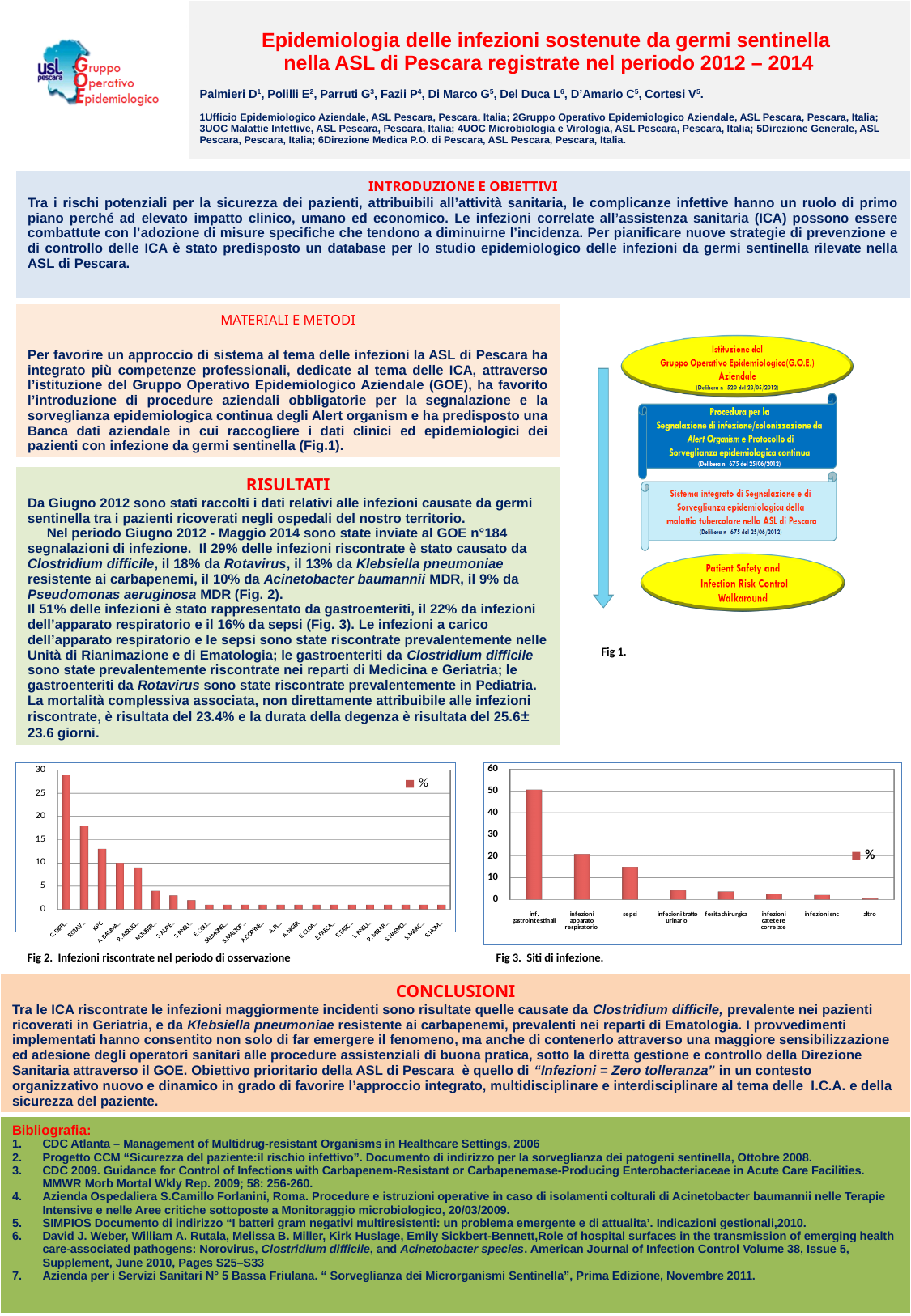
In Fig 3 (Siti di infezione), how many series does the legend list? 1 In Fig 3 (Siti di infezione), how many categories are shown on the x axis? 8 In Fig 3 (Siti di infezione), is the value for inf. gastrointestinali greater or less than 40? greater In Fig 3 (Siti di infezione), which site of infection has the highest value? inf. gastrointestinali In Fig 2 (Infezioni riscontrate nel periodo di osservazione), do the values rise or fall from left to right along the x axis? fall In Fig 3 (Siti di infezione), is the value for sepsi greater or less than 10? greater In Fig 3 (Siti di infezione), is the value for infezioni apparato respiratorio greater or less than 30? less In Fig 3 (Siti di infezione), which is larger: sepsi or infezioni tratto urinario? sepsi In Fig 3 (Siti di infezione), which category has the lowest value? altro What kind of chart is Fig 3 (Siti di infezione)? bar chart In Fig 2 (Infezioni riscontrate nel periodo di osservazione), which category has the highest value? C. DIFFICILE